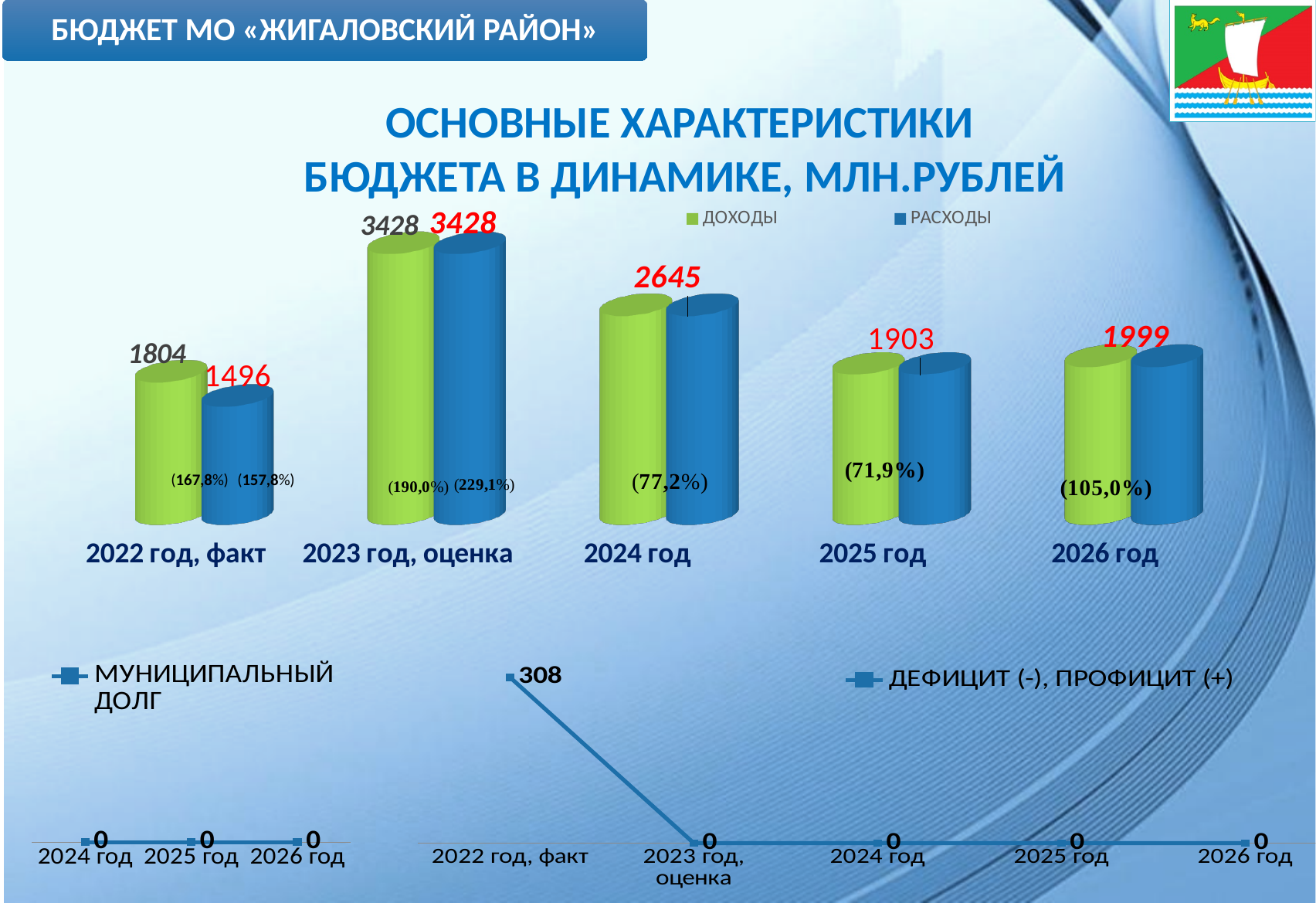
In the top bar chart, which year has the highest ДОХОДЫ? 2023 год, оценка In the top bar chart, what is the difference between ДОХОДЫ and РАСХОДЫ for «2022 год, факт»? 308 In the top bar chart, which is larger for «2022 год, факт»: ДОХОДЫ or РАСХОДЫ? ДОХОДЫ In the bottom-left line chart «МУНИЦИПАЛЬНЫЙ ДОЛГ», what is the value for «2025 год»? 0 In the top bar chart, what is the value of ДОХОДЫ for «2023 год, оценка»? 3428 How many year categories are shown on the x axis of the top bar chart? 5 In the top bar chart, what is the value of РАСХОДЫ for «2022 год, факт»? 1496 In the bottom-right line chart «ДЕФИЦИТ (-), ПРОФИЦИТ (+)», what is the value for «2022 год, факт»? 308 What kind of chart is the top chart titled «ОСНОВНЫЕ ХАРАКТЕРИСТИКИ БЮДЖЕТА В ДИНАМИКЕ, МЛН.РУБЛЕЙ»? bar chart How many series does the legend of the top bar chart list? 2 In the top bar chart, what is the value of РАСХОДЫ for «2024 год»? 2645 In the top bar chart, what is the value of ДОХОДЫ for «2022 год, факт»? 1804